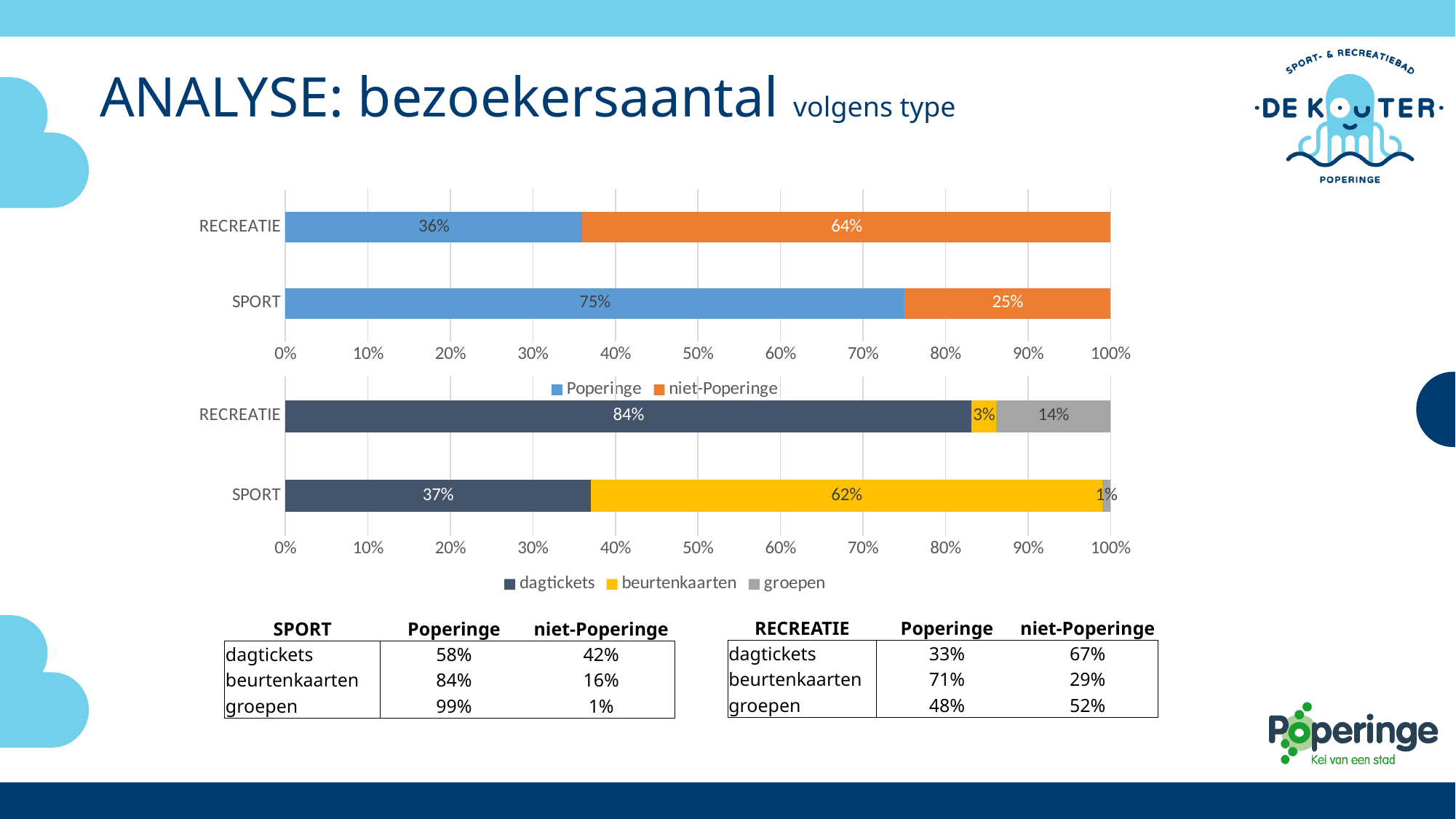
In the upper chart (legend Poperinge / niet-Poperinge), how many series does the legend list? 2 In the lower chart (legend dagtickets / beurtenkaarten / groepen), how many series does the legend list? 3 What kind of chart is the lower chart (legend dagtickets / beurtenkaarten / groepen)? Stacked bar chart In the lower chart (legend dagtickets / beurtenkaarten / groepen), what is the beurtenkaarten value for SPORT? 62% In the upper chart (legend Poperinge / niet-Poperinge), what is the Poperinge value for RECREATIE? 36% In the lower chart (legend dagtickets / beurtenkaarten / groepen), what is the groepen value for RECREATIE? 14% In the upper chart (legend Poperinge / niet-Poperinge), which category has the higher Poperinge share, RECREATIE or SPORT? SPORT In the upper chart (legend Poperinge / niet-Poperinge), what is the niet-Poperinge value for SPORT? 25% In the lower chart (legend dagtickets / beurtenkaarten / groepen), what is the dagtickets value for RECREATIE? 84% In the upper chart (legend Poperinge / niet-Poperinge), what is the difference between the niet-Poperinge values for RECREATIE and SPORT? 39% How many categories are shown on the y axis of the upper chart (legend Poperinge / niet-Poperinge)? 2 In the lower chart (legend dagtickets / beurtenkaarten / groepen), which series has the smallest value for SPORT? groepen